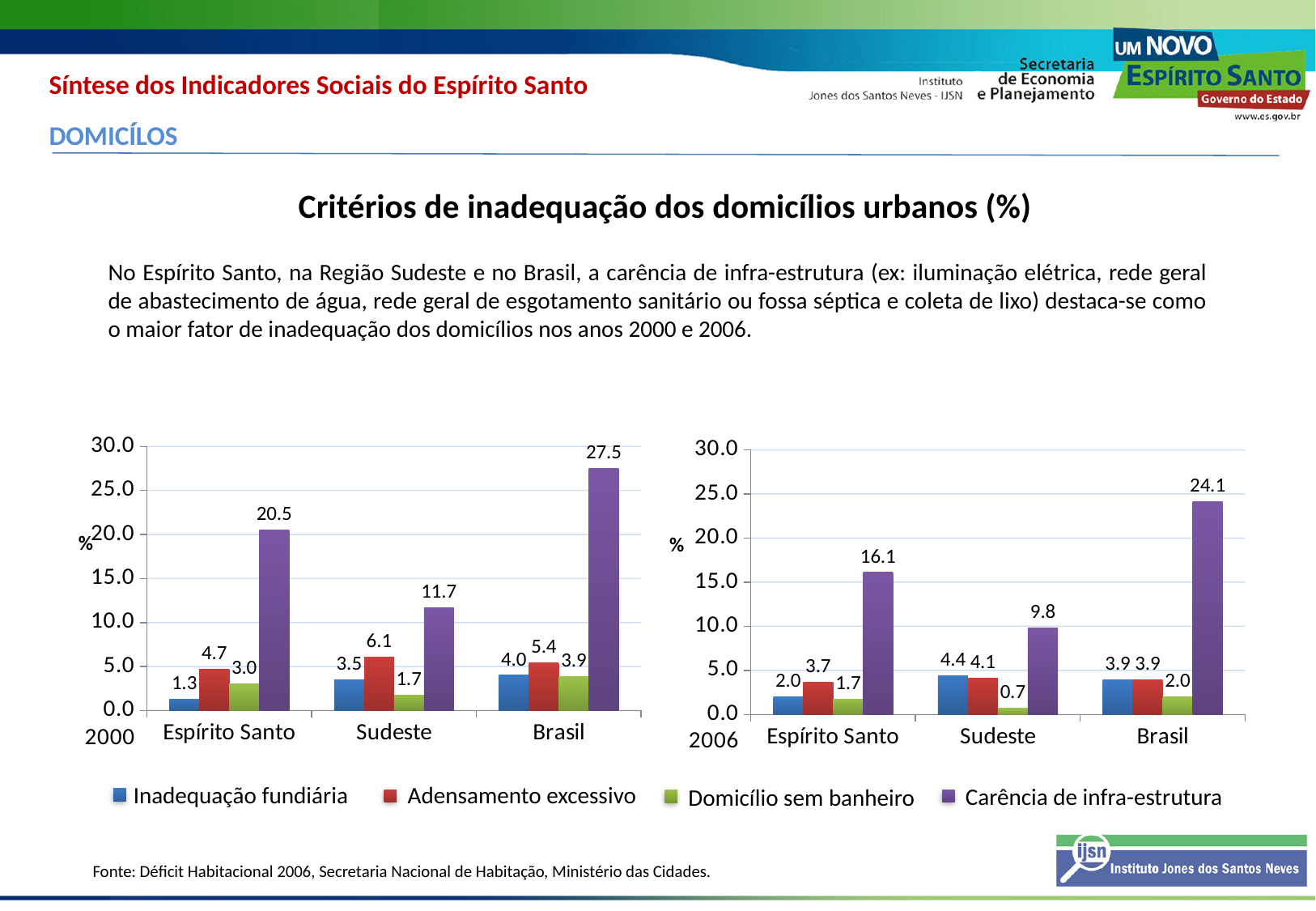
In the 2000 chart (left), what is the value of Inadequação fundiária for Espírito Santo? 1.3 In the 2006 chart (right), what is the value of Carência de infra-estrutura for Espírito Santo? 16.1 In the 2006 chart (right), is the value of Carência de infra-estrutura for Brasil greater or less than 20.0? greater What is the difference between the Carência de infra-estrutura value for Brasil in the 2000 chart and in the 2006 chart? 3.4 In the 2000 chart (left), which region has the highest value for Carência de infra-estrutura? Brasil What type of chart is the 2000 chart (left)? Bar chart In the 2000 chart (left), which is larger for Sudeste: Adensamento excessivo or Inadequação fundiária? Adensamento excessivo In the 2006 chart (right), what is the value of Domicílio sem banheiro for Sudeste? 0.7 In the 2000 chart (left), what is the value of Carência de infra-estrutura for Brasil? 27.5 How many regions are shown on the x axis of the 2006 chart (right)? 3 In the 2006 chart (right), which region has the lowest value for Carência de infra-estrutura? Sudeste How many series does the legend list for the charts? 4